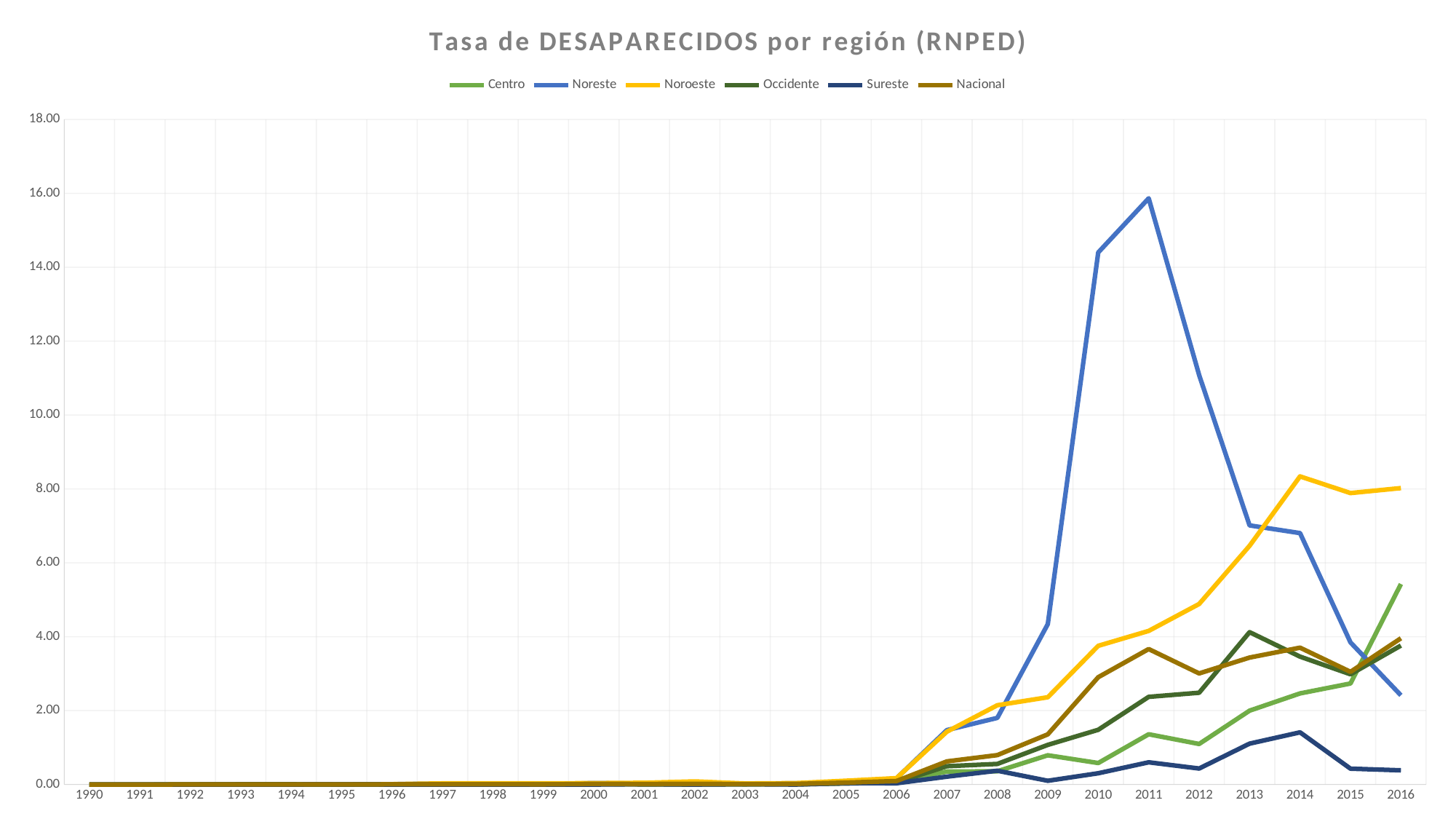
In 2010, which is larger: Noreste or Noroeste? Noreste What is the title of the chart? Tasa de DESAPARECIDOS por región (RNPED) Which series has the lowest value in 2016? Sureste How many series does the legend list? 6 In which year does the Noreste series reach its peak? 2011 What kind of chart is shown on the slide? Line chart Is the value for Noroeste in 2012 greater or less than 6.00? less In 2016, which is larger: Centro or Noreste? Centro Which series reaches the highest value anywhere on the chart? Noreste How many years are shown along the x axis? 27 Does the Noreste series rise or fall from 2011 to 2016? Falls Is the value for Noreste in 2011 greater or less than 14.00? greater